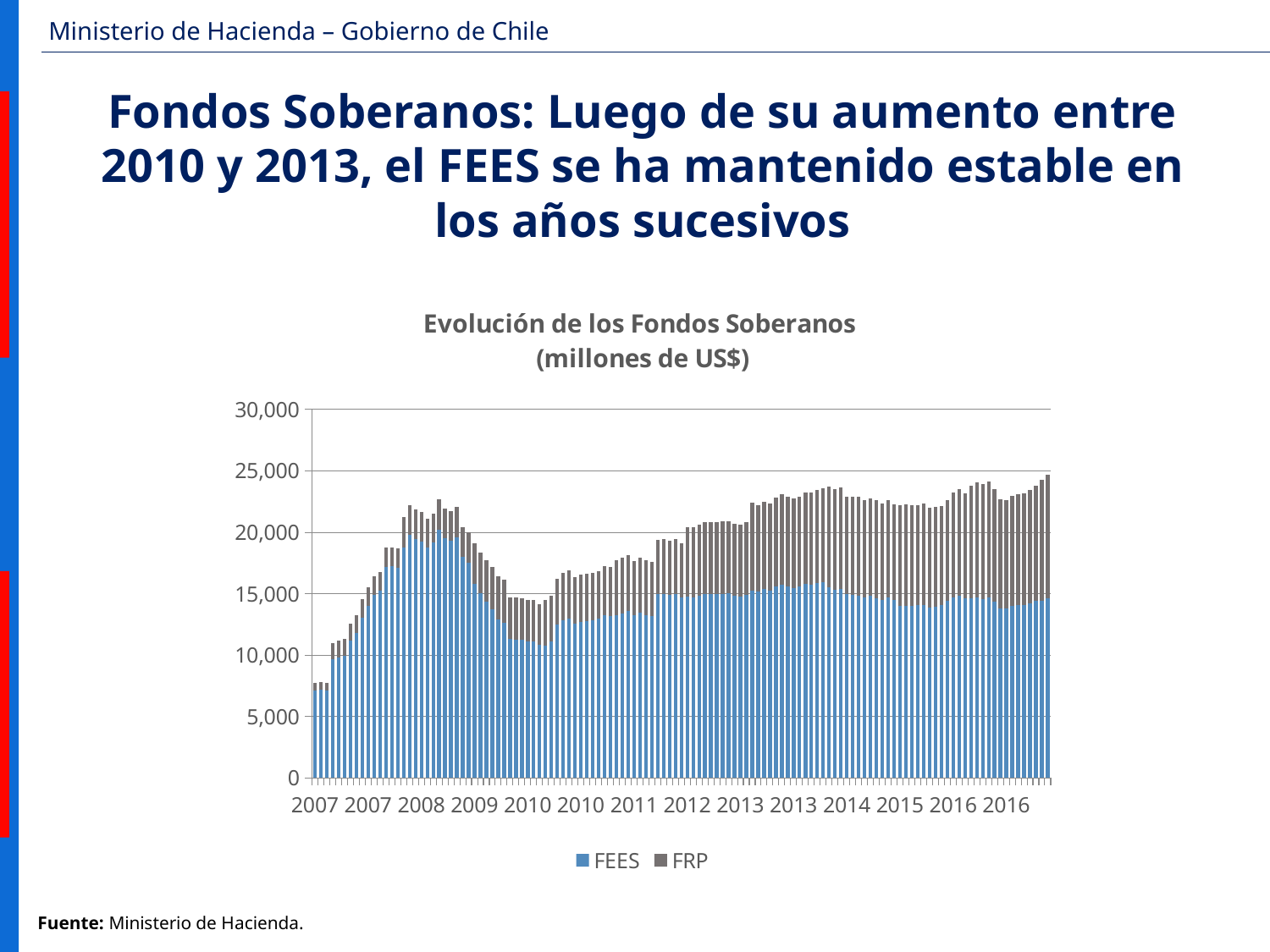
What is the title of the chart? Evolución de los Fondos Soberanos (millones de US$) Overall, do the total values of the bars rise or fall from 2007 to 2016? rise What are the two series named in the legend? FEES and FRP Is the total value of the first bar (2007) greater or less than 10,000? less What is the highest value shown on the vertical axis? 30,000 Is the FEES value in the last bar (2016) greater or less than 10,000? greater Is the total value of the last bar (2016) greater or less than 20,000? greater How many series does the legend list? 2 What kind of chart is shown on the slide? Stacked bar chart